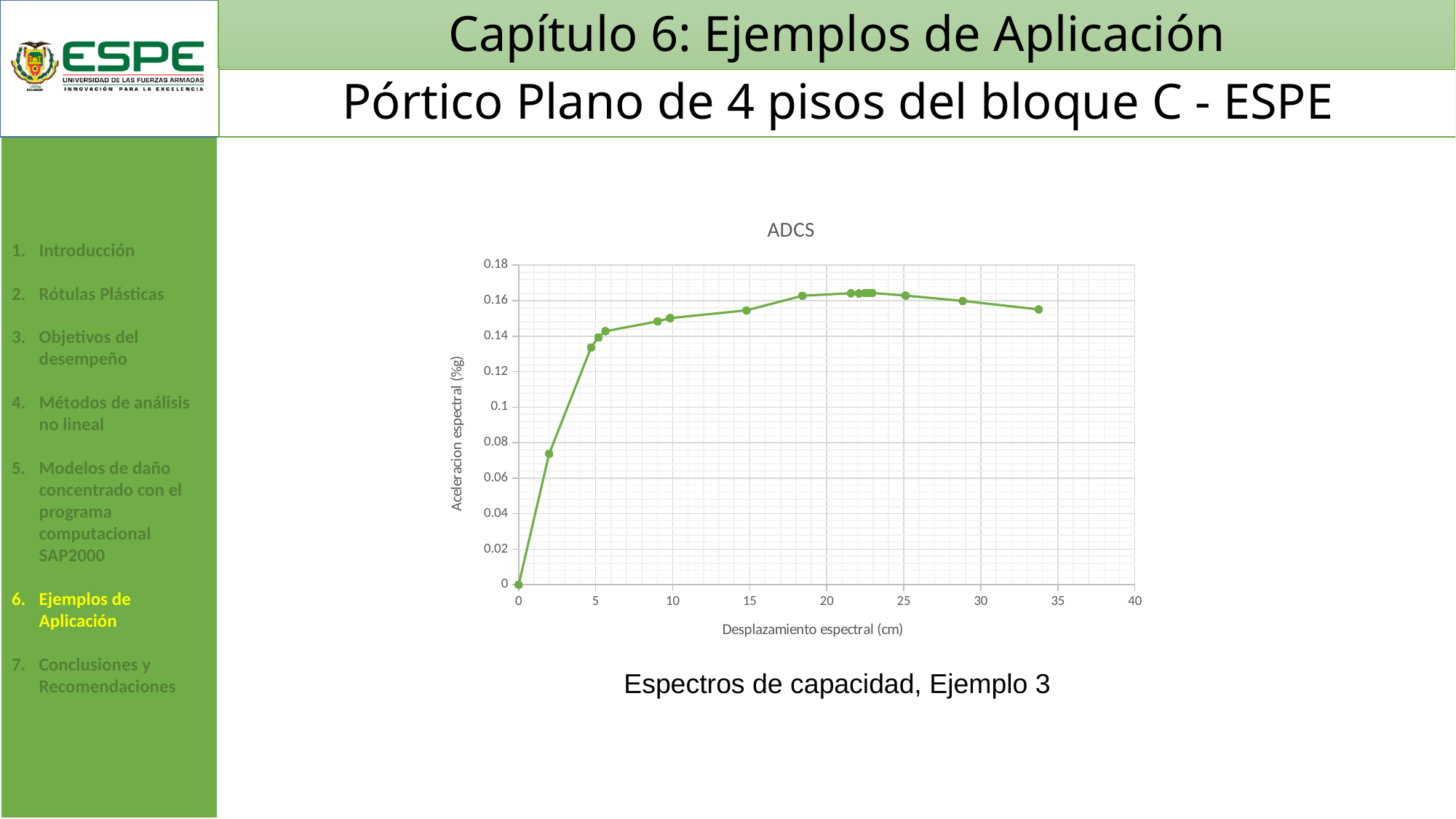
Which is larger: the spectral acceleration at about 2 cm or at about 34 cm of spectral displacement? at about 34 cm Is the largest spectral displacement plotted greater or less than 35 cm? less What kind of chart is shown on the slide? line chart Is the spectral acceleration at a spectral displacement of about 2 cm greater or less than 0.08? less Is the spectral acceleration at a spectral displacement of about 5 cm greater or less than 0.12? greater What is the label of the x axis of the chart? Desplazamiento espectral (cm) What is the title of the chart? ADCS Does the spectral acceleration rise or fall as spectral displacement increases from 0 to 20 cm? rise What is the spectral acceleration value at a spectral displacement of 0 cm? 0